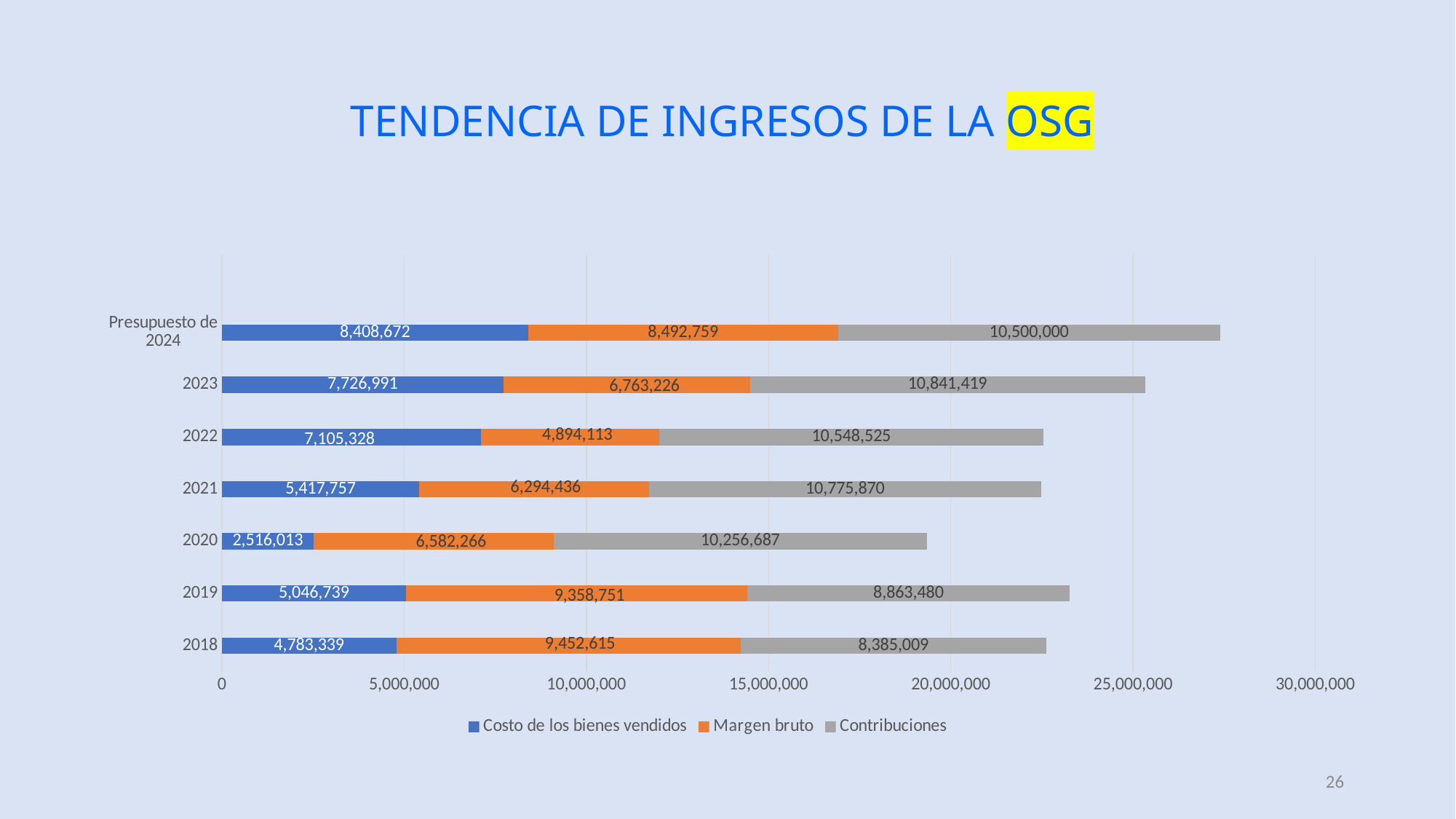
Which category has the highest value for Margen bruto? 2018 Which category has the lowest value for Costo de los bienes vendidos? 2020 How many categories (years) are shown on the chart? 7 What type of chart is shown on the slide? Stacked bar chart Which category has the highest value for Contribuciones? 2023 How many series does the legend list? 3 What is the difference between Costo de los bienes vendidos for Presupuesto de 2024 and for 2023? 681,681 Which is larger: Margen bruto for 2022 or Margen bruto for 2021? 2021 What is the value of Costo de los bienes vendidos for 2021? 5,417,757 What is the value of Contribuciones for Presupuesto de 2024? 10,500,000 What is the value of Margen bruto for 2020? 6,582,266 What is the total of the stacked bar for 2020? 19,354,966